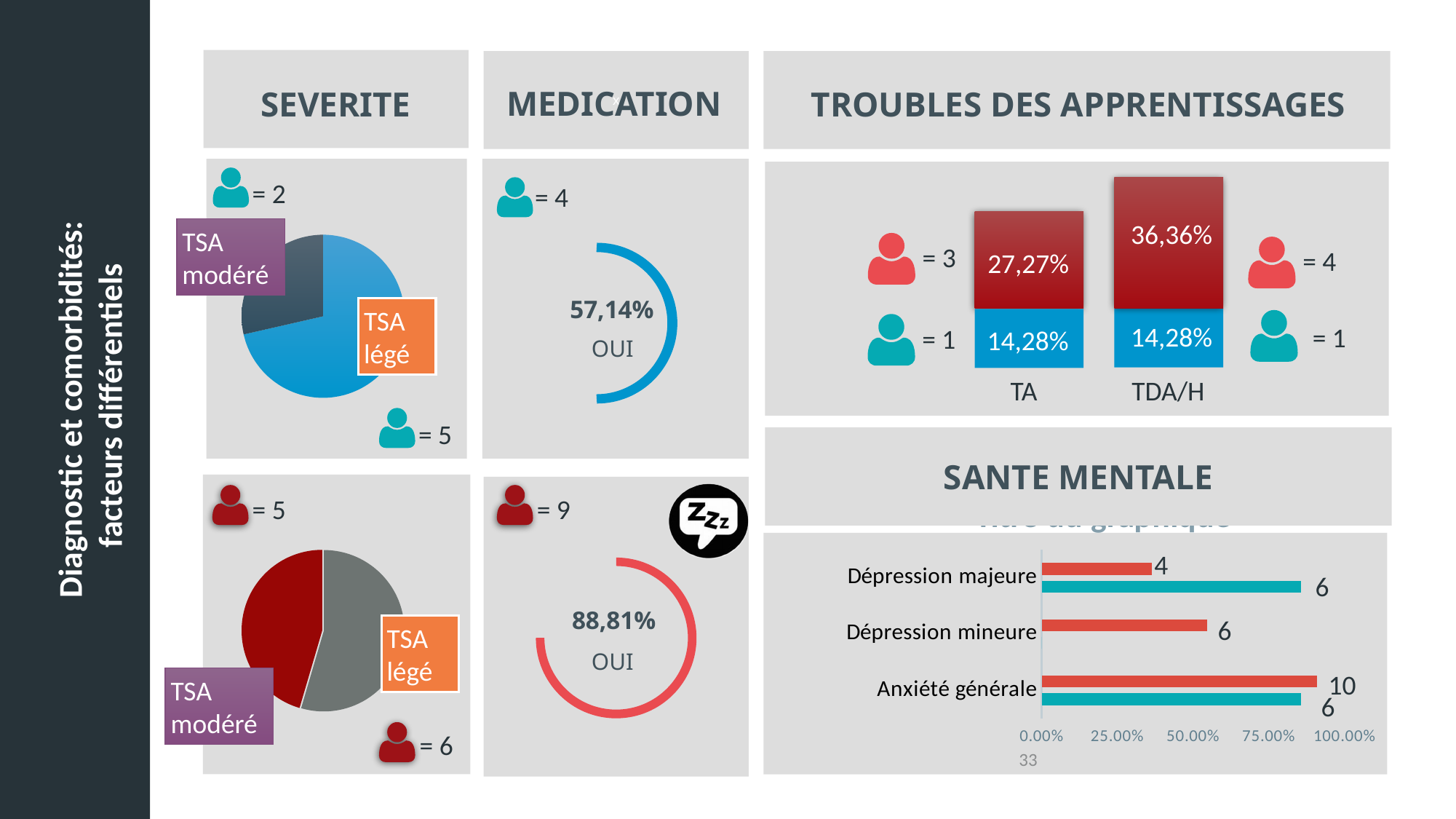
In the SANTE MENTALE chart, what kind of chart is shown? bar chart In the top SEVERITE pie chart, what is the count shown for TSA légé? 5 In the SANTE MENTALE chart, what is the value labelled on the teal bar for Dépression majeure? 6 In the SANTE MENTALE chart, what is the difference between the red bar value and the teal bar value for Anxiété générale? 4 In the TROUBLES DES APPRENTISSAGES chart, how many categories are shown on the x axis? 2 In the TROUBLES DES APPRENTISSAGES chart, what percentage is shown in the red segment for TDA/H? 36,36% In the SANTE MENTALE chart, which category has the highest red bar value? Anxiété générale In the top MEDICATION gauge, what percentage is shown for OUI? 57,14% In the SANTE MENTALE chart, what is the value labelled on the red bar for Anxiété générale? 10 In the TROUBLES DES APPRENTISSAGES chart, what percentage is shown in the blue segment for TA? 14,28% In the SANTE MENTALE chart, how many categories are listed on the vertical axis? 3 In the TROUBLES DES APPRENTISSAGES chart, which category has the larger red segment, TA or TDA/H? TDA/H